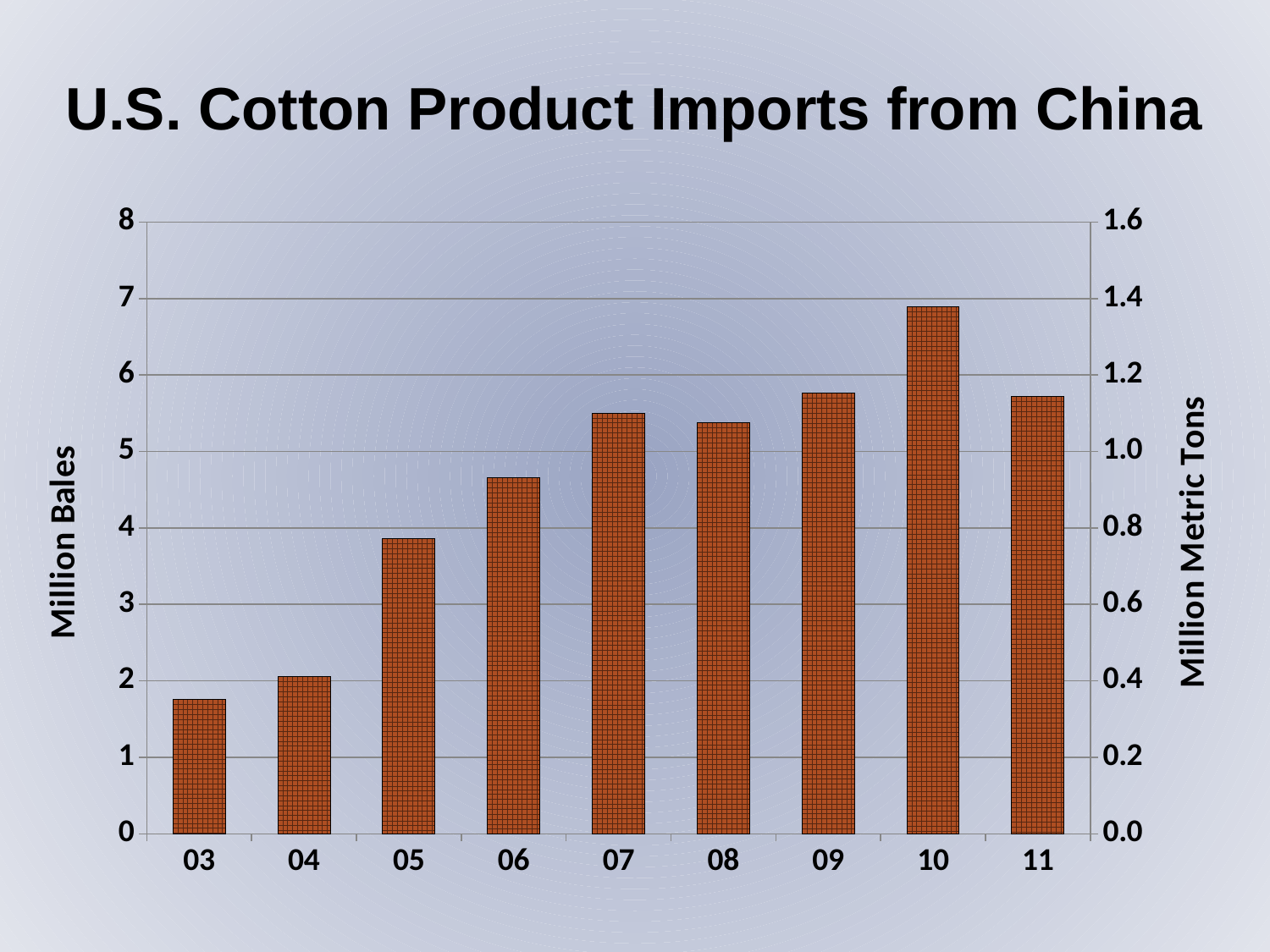
What kind of chart is shown on the slide? bar chart How many years are plotted on the chart? 9 Do the values rise or fall from 03 to 07? rise Is the value for 05 greater or less than 4 million bales? less Is the value for 03 greater or less than 2 million bales? less Which is larger, the value for 05 or the value for 06? 06 Is the value for 10 greater or less than 6 million bales? greater Which year has the lowest value? 03 What is the label on the right-hand vertical axis? Million Metric Tons Which year has the highest value? 10